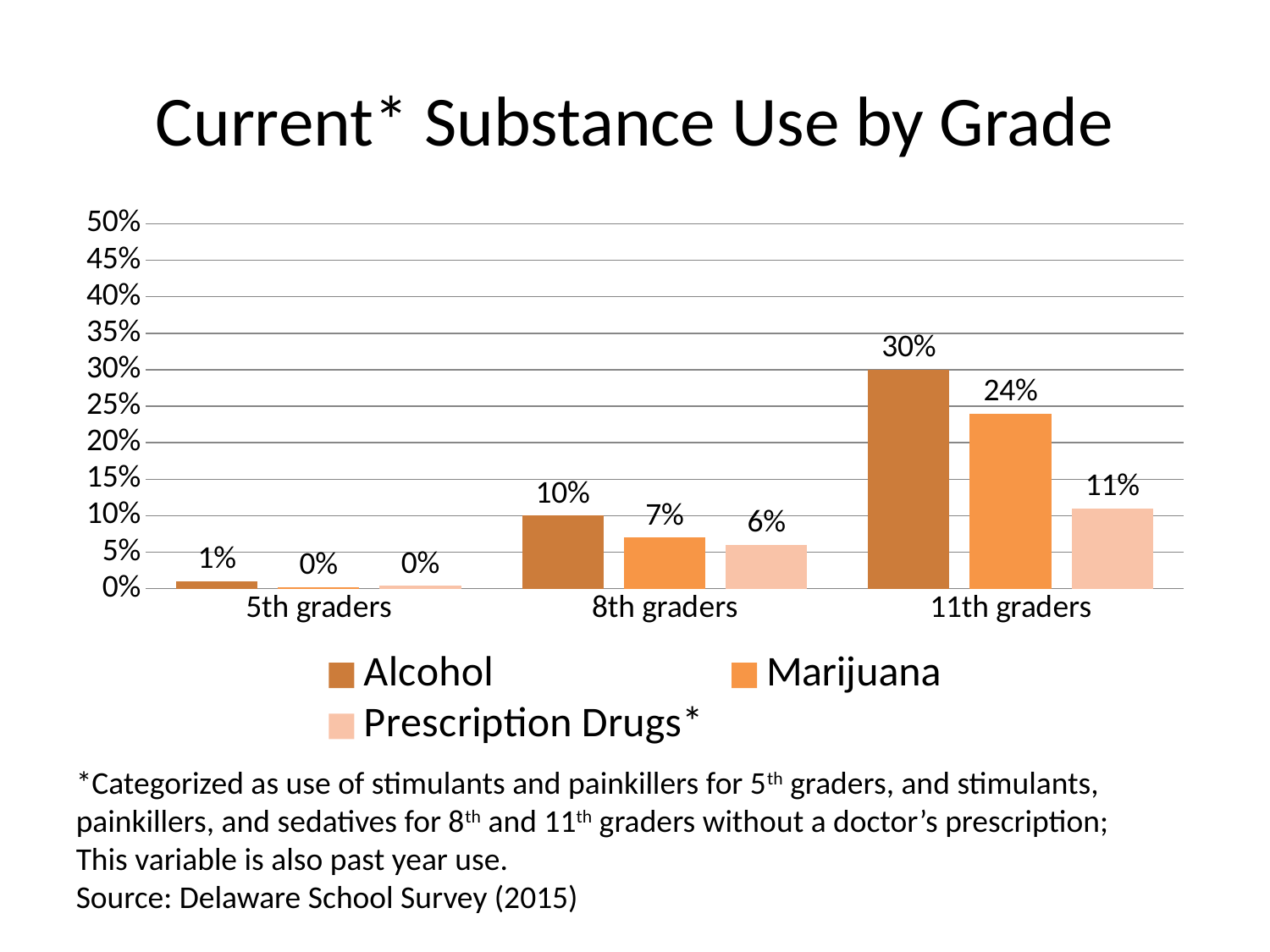
Which grade has the highest Alcohol value? 11th graders How many grade categories are shown on the x axis? 3 What is the Marijuana value for 8th graders? 7% Which grade has the lowest Marijuana value? 5th graders What is the Alcohol value for 11th graders? 30% What is the Alcohol value for 5th graders? 1% Is the Marijuana value for 11th graders greater or less than 20%? greater What kind of chart is shown on the slide? Bar chart What is the difference between the Alcohol and Marijuana values for 11th graders? 6% How many series does the legend list? 3 What is the Prescription Drugs* value for 11th graders? 11% Which is larger for 8th graders, Alcohol or Prescription Drugs*? Alcohol